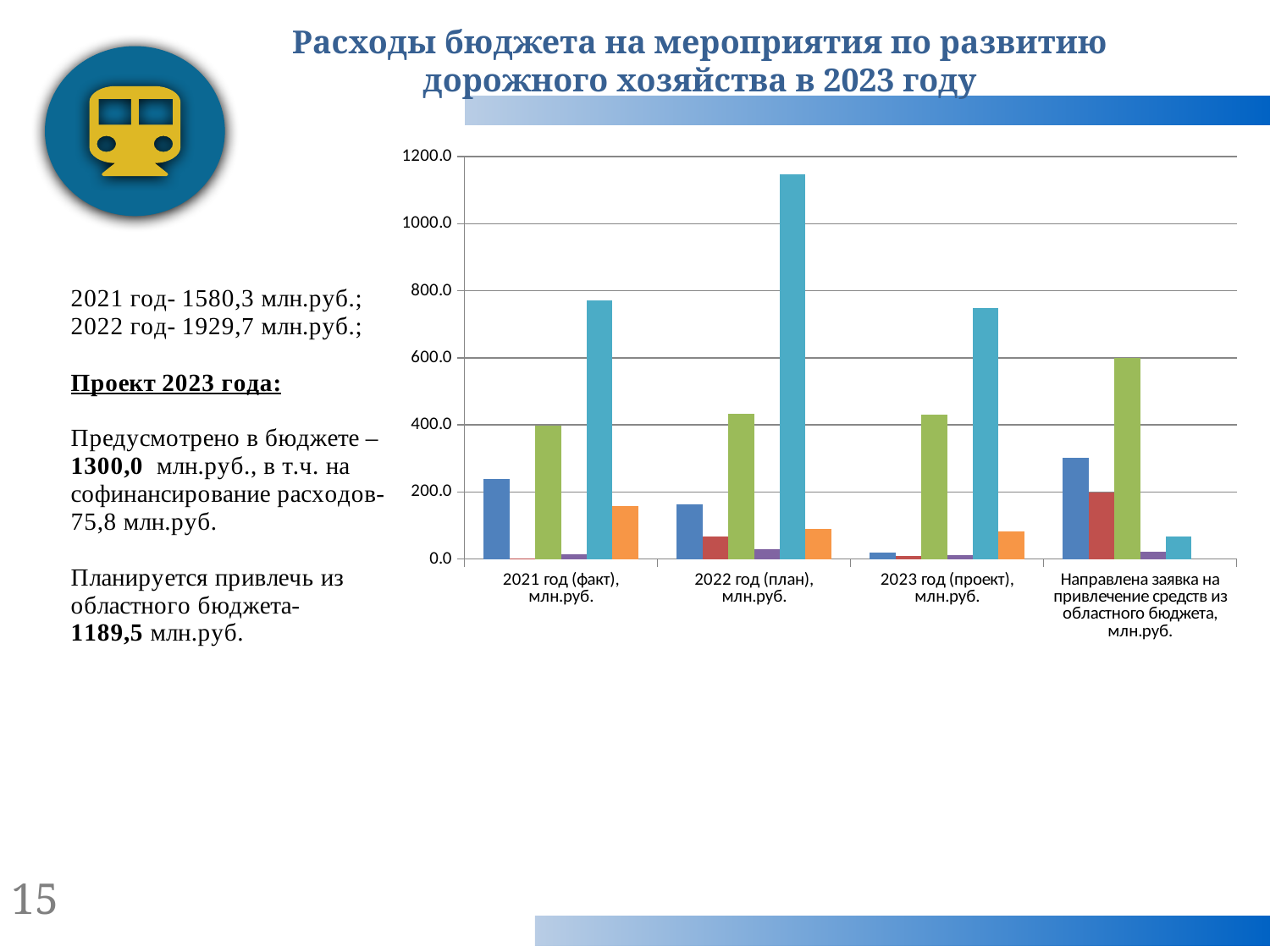
Is the value of the orange bar in the '2021 год (факт), млн.руб.' category greater or less than 200? less Which category contains the tallest bar in the chart? 2022 год (план), млн.руб. Is the value of the light blue bar in the '2023 год (проект), млн.руб.' category greater or less than 600? greater Which is larger: the light blue bar for '2022 год (план), млн.руб.' or the light blue bar for '2021 год (факт), млн.руб.'? 2022 год (план), млн.руб. What kind of chart is shown on the slide? bar chart Is the value of the tallest (light blue) bar in the '2022 год (план), млн.руб.' category greater or less than 1000? greater What is the highest tick value shown on the vertical axis of the chart? 1200.0 How many categories are shown on the x axis of the chart? 4 What is the title of the slide containing the chart? Расходы бюджета на мероприятия по развитию дорожного хозяйства в 2023 году